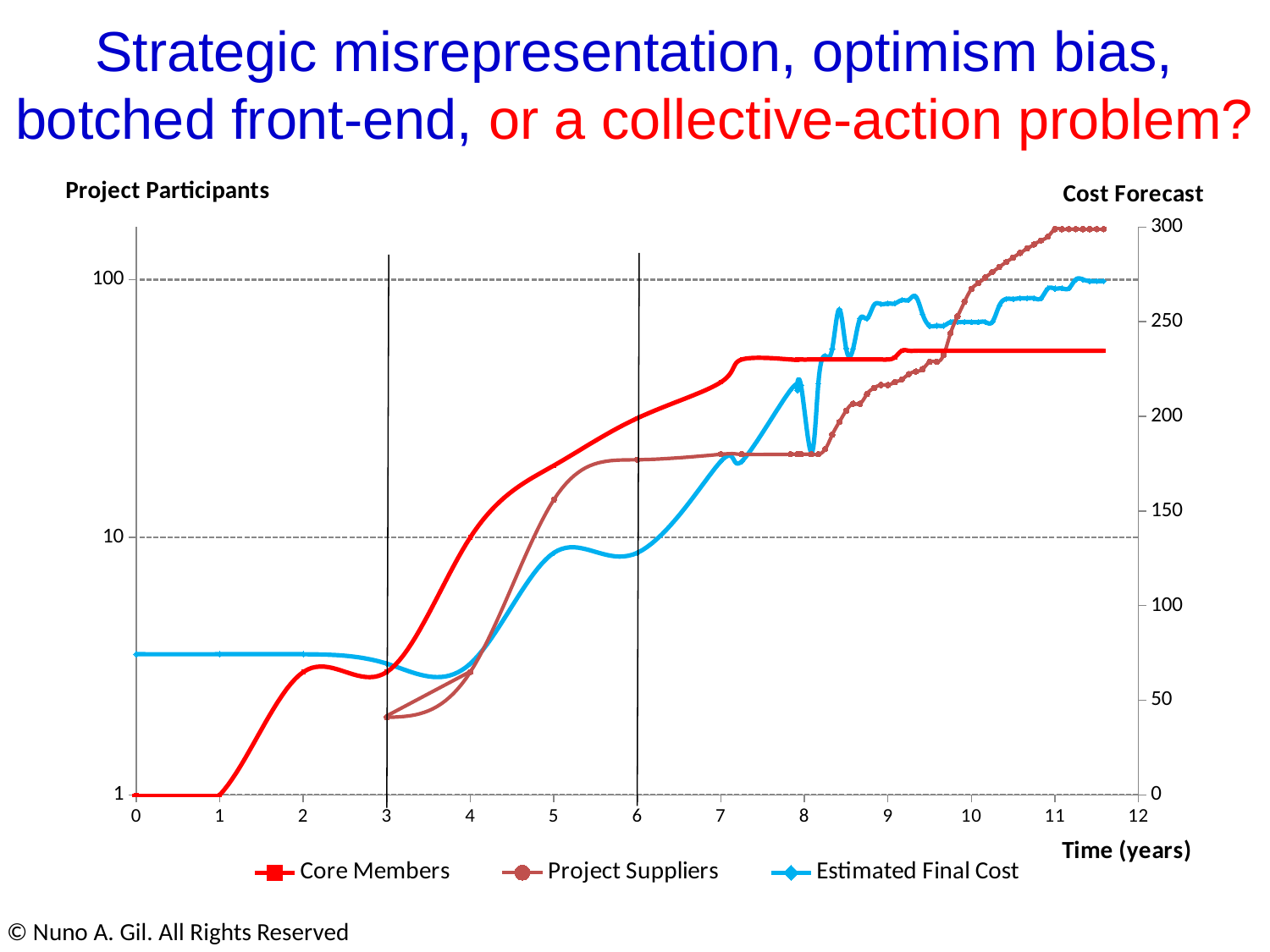
How many series does the legend list? 3 Is the Estimated Final Cost at year 11 greater or less than 250? greater What is the value of Core Members at year 1? 1 What is the value of Core Members at year 0? 1 At year 6, which is larger: Core Members or Project Suppliers? Core Members What kind of chart is shown on the slide? line chart Is the value for Core Members at year 6 greater or less than 10? greater Is the Estimated Final Cost at year 0 greater or less than 50? greater What is the title of the x axis? Time (years) Does the Core Members line rise or fall overall from year 0 to year 12? rise